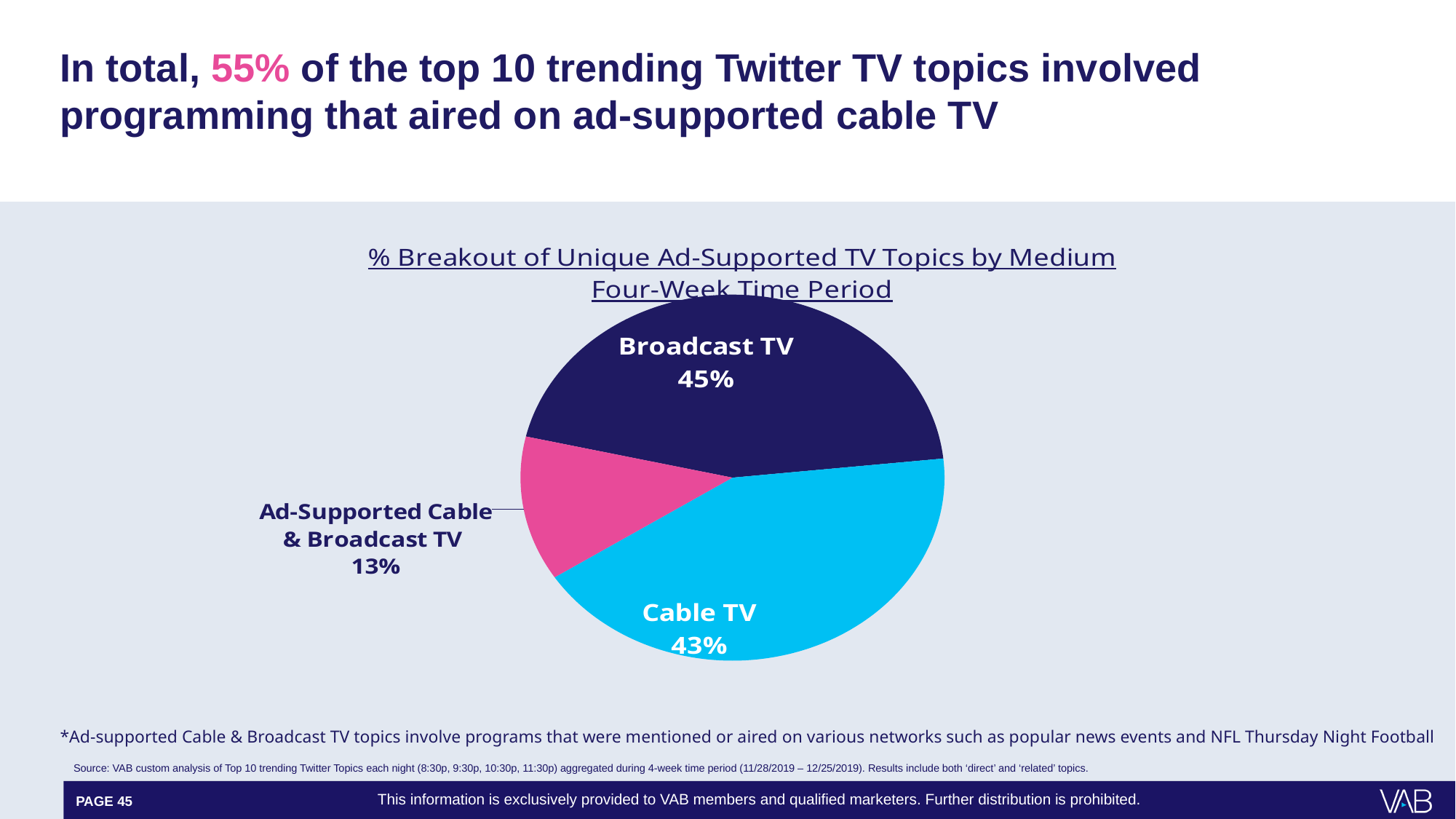
What share of the pie does Ad-Supported Cable & Broadcast TV account for? 13% What share of the pie does Broadcast TV account for? 45% What colour is the Cable TV slice of the pie? Light blue How many slices does the pie chart have? 3 What is the difference in percentage points between Broadcast TV and Cable TV? 2 percentage points Which slice of the pie is the smallest? Ad-Supported Cable & Broadcast TV Which is larger, the Cable TV slice or the Ad-Supported Cable & Broadcast TV slice? Cable TV What is the title of the pie chart? % Breakout of Unique Ad-Supported TV Topics by Medium Four-Week Time Period Which slice of the pie is the largest? Broadcast TV What is the difference in percentage points between Cable TV and Ad-Supported Cable & Broadcast TV? 30 percentage points What share of the pie does Cable TV account for? 43% What type of chart is shown on the slide? Pie chart